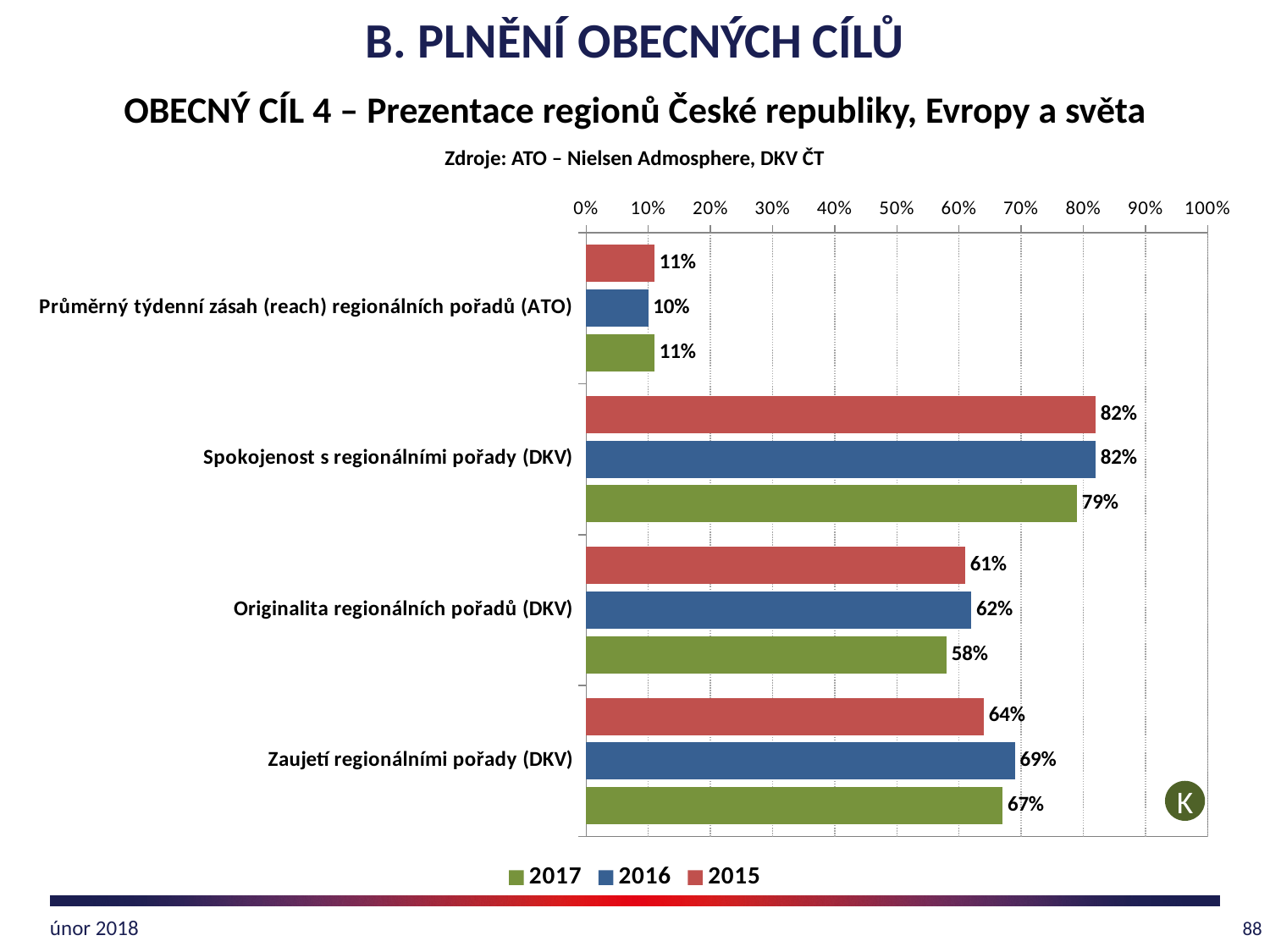
Which category has the highest 2016 value? Spokojenost s regionálními pořady (DKV) What is the 2017 value for Spokojenost s regionálními pořady (DKV)? 79% What is the 2016 value for Průměrný týdenní zásah (reach) regionálních pořadů (ATO)? 10% Which is larger for Originalita regionálních pořadů (DKV): the 2016 value or the 2017 value? 2016 How many categories are shown on the chart? 4 What is the 2015 value for Originalita regionálních pořadů (DKV)? 61% What is the 2016 value for Zaujetí regionálními pořady (DKV)? 69% Which series is shown in green in the legend? 2017 What kind of chart is shown on the slide? Bar chart What is the difference between the 2016 and 2017 values for Zaujetí regionálními pořady (DKV)? 2% How many series does the legend list? 3 Which category has the lowest 2017 value? Průměrný týdenní zásah (reach) regionálních pořadů (ATO)